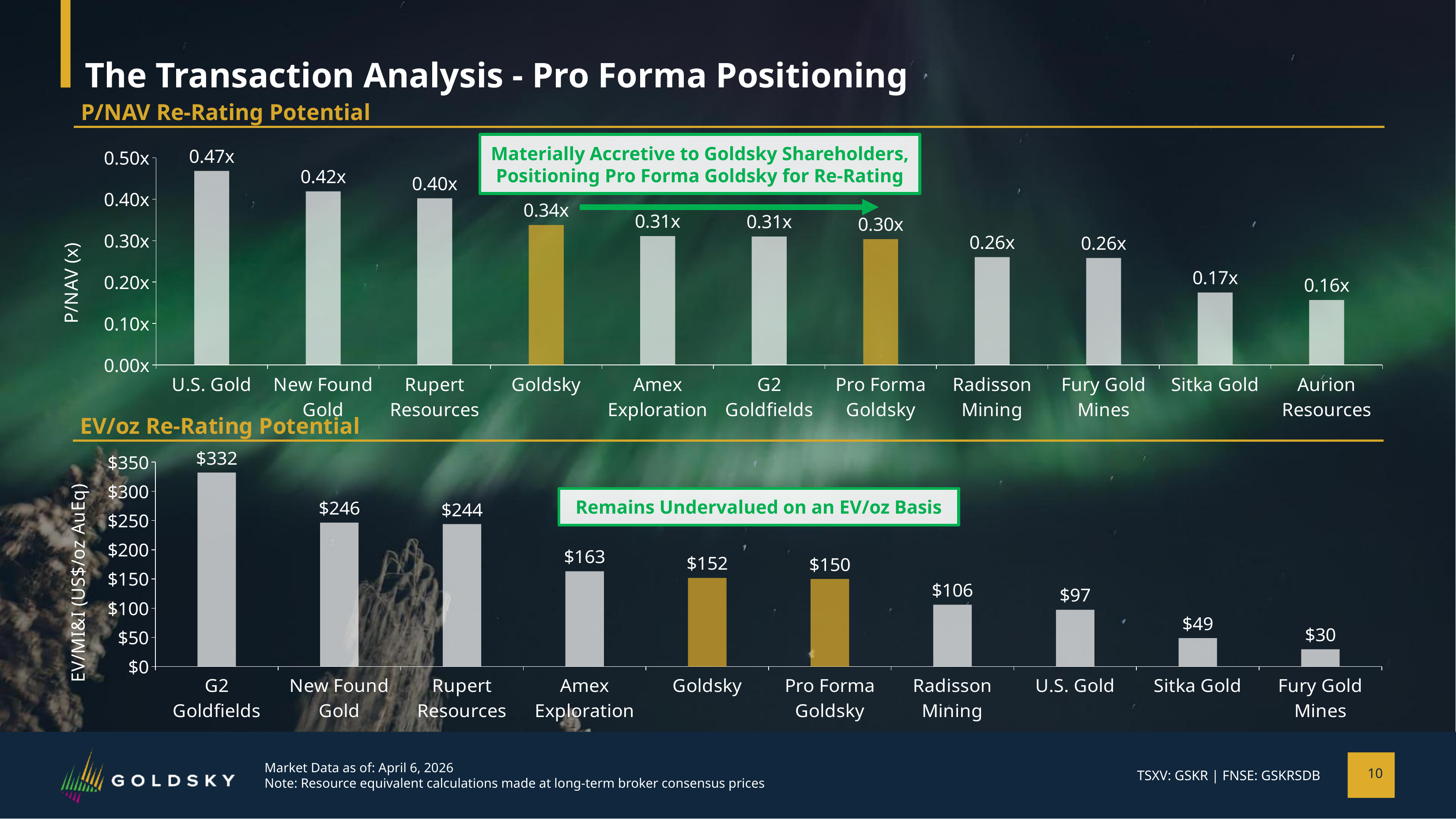
What type of chart is the EV/oz Re-Rating Potential chart? Bar chart In the EV/oz Re-Rating Potential chart, which company has the highest EV/MI&I? G2 Goldfields In the EV/oz Re-Rating Potential chart, which company has the lowest EV/MI&I? Fury Gold Mines In the P/NAV Re-Rating Potential chart, which company has the lowest P/NAV? Aurion Resources In the P/NAV Re-Rating Potential chart, which company has the highest P/NAV? U.S. Gold In the P/NAV Re-Rating Potential chart, what is the difference between the P/NAV of U.S. Gold and Pro Forma Goldsky? 0.17x In the P/NAV Re-Rating Potential chart, what is the P/NAV value for Sitka Gold? 0.17x In the P/NAV Re-Rating Potential chart, what is the P/NAV value for Goldsky? 0.34x In the P/NAV Re-Rating Potential chart, how many companies are shown? 11 In the EV/oz Re-Rating Potential chart, which is larger, the value for Radisson Mining or U.S. Gold? Radisson Mining In the EV/oz Re-Rating Potential chart, what is the difference between the values for G2 Goldfields and Goldsky? $180 In the EV/oz Re-Rating Potential chart, what is the EV/MI&I value for Pro Forma Goldsky? $150